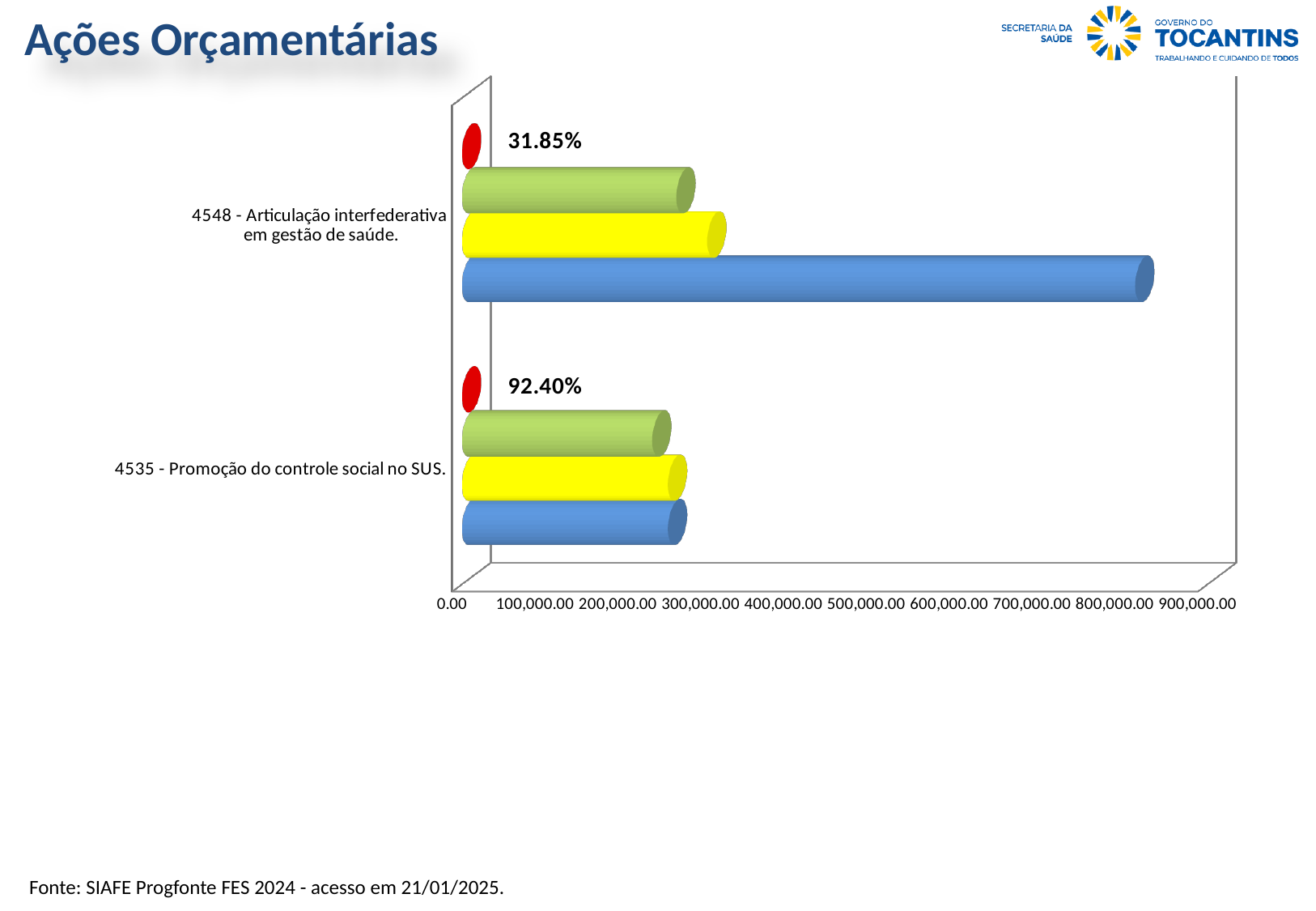
Which category has the higher percentage label? 4535 - Promoção do controle social no SUS. What is the difference between the two percentage labels shown on the chart? 60.55% What is the title of the slide containing the chart? Ações Orçamentárias What percentage is shown for the category "4535 - Promoção do controle social no SUS."? 92.40% Is the blue bar for "4548 - Articulação interfederativa em gestão de saúde." greater or less than 800,000.00? greater What kind of chart is shown on the slide? Bar chart Is the blue bar for "4535 - Promoção do controle social no SUS." greater or less than 300,000.00? less Which category has the lower percentage label? 4548 - Articulação interfederativa em gestão de saúde. How many categories are shown on the chart? 2 What is the highest value shown on the horizontal axis? 900,000.00 Which category has the longer blue bar? 4548 - Articulação interfederativa em gestão de saúde. What percentage is shown for the category "4548 - Articulação interfederativa em gestão de saúde."? 31.85%